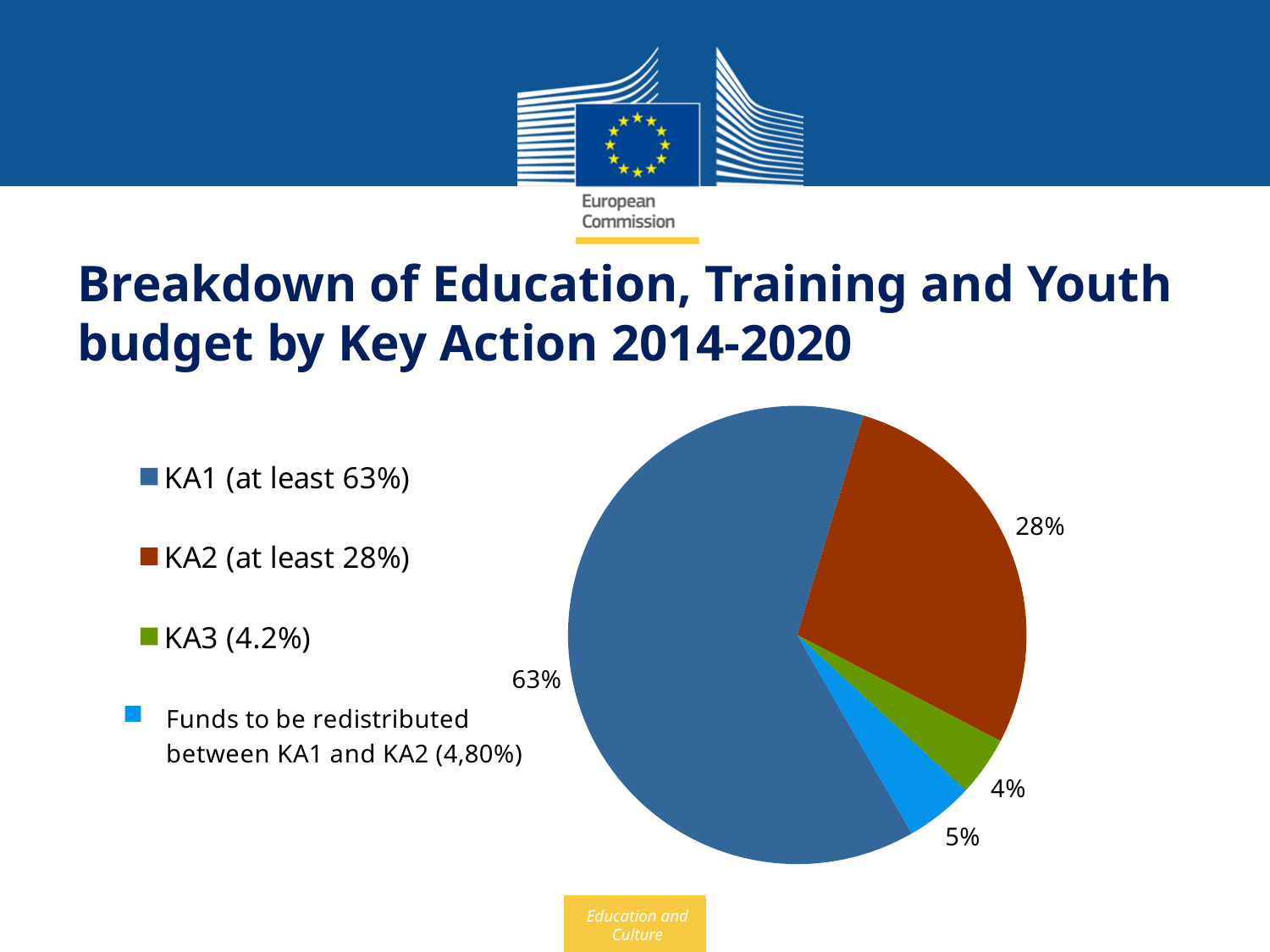
What kind of chart is shown on the slide? Pie chart What does the legend entry for KA3 say? KA3 (4.2%) Which slice of the pie is the smallest? KA3 What is the title of the slide containing the chart? Breakdown of Education, Training and Youth budget by Key Action 2014-2020 What percentage label is shown on the slice for funds to be redistributed between KA1 and KA2? 5% What percentage of the budget does the KA2 slice represent? 28% Which is larger: the KA3 slice or the slice for funds to be redistributed between KA1 and KA2? Funds to be redistributed between KA1 and KA2 What percentage label is shown on the KA3 slice? 4% What percentage of the budget does the KA1 slice represent? 63% How many slices does the pie chart have? 4 Which Key Action has the largest share of the budget? KA1 How many percentage points larger is the KA1 share than the KA2 share? 35 percentage points